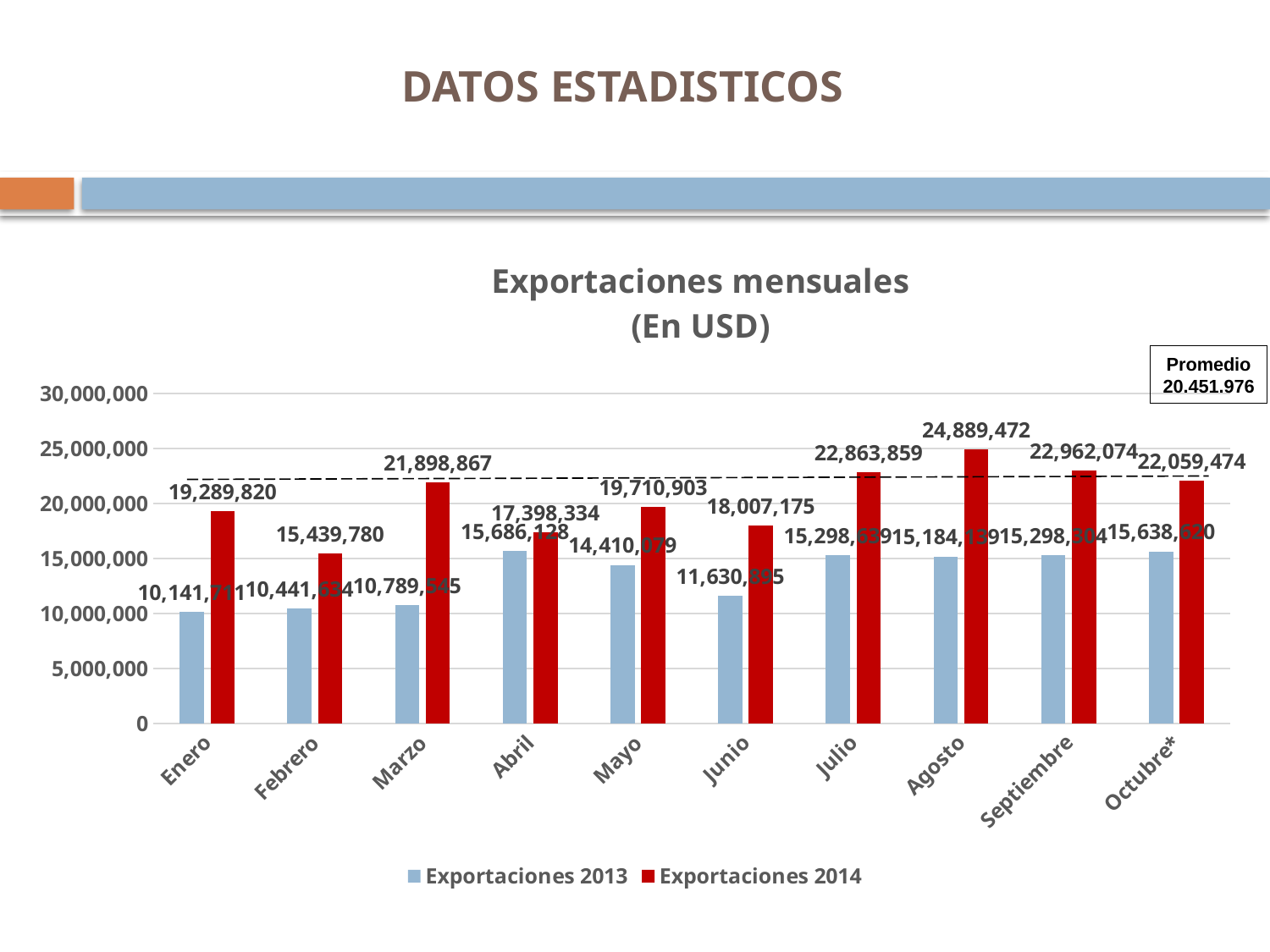
What is the value of Exportaciones 2014 for Marzo? 21,898,867 Which month has the highest value for Exportaciones 2014? Agosto How many months are shown on the x axis? 10 What is the value of Exportaciones 2014 for Agosto? 24,889,472 Is the value of Exportaciones 2013 for Enero greater or less than 15,000,000? less Which is larger for Exportaciones 2014: Enero or Mayo? Mayo What is the difference between Exportaciones 2014 for Agosto and for Febrero? 9,449,692 Which month has the lowest value for Exportaciones 2014? Febrero How many series does the legend list? 2 What is the difference between Exportaciones 2014 and Exportaciones 2013 for Abril? 1,712,206 What kind of chart is shown on the slide? bar chart What is the value of Exportaciones 2013 for Abril? 15,686,128